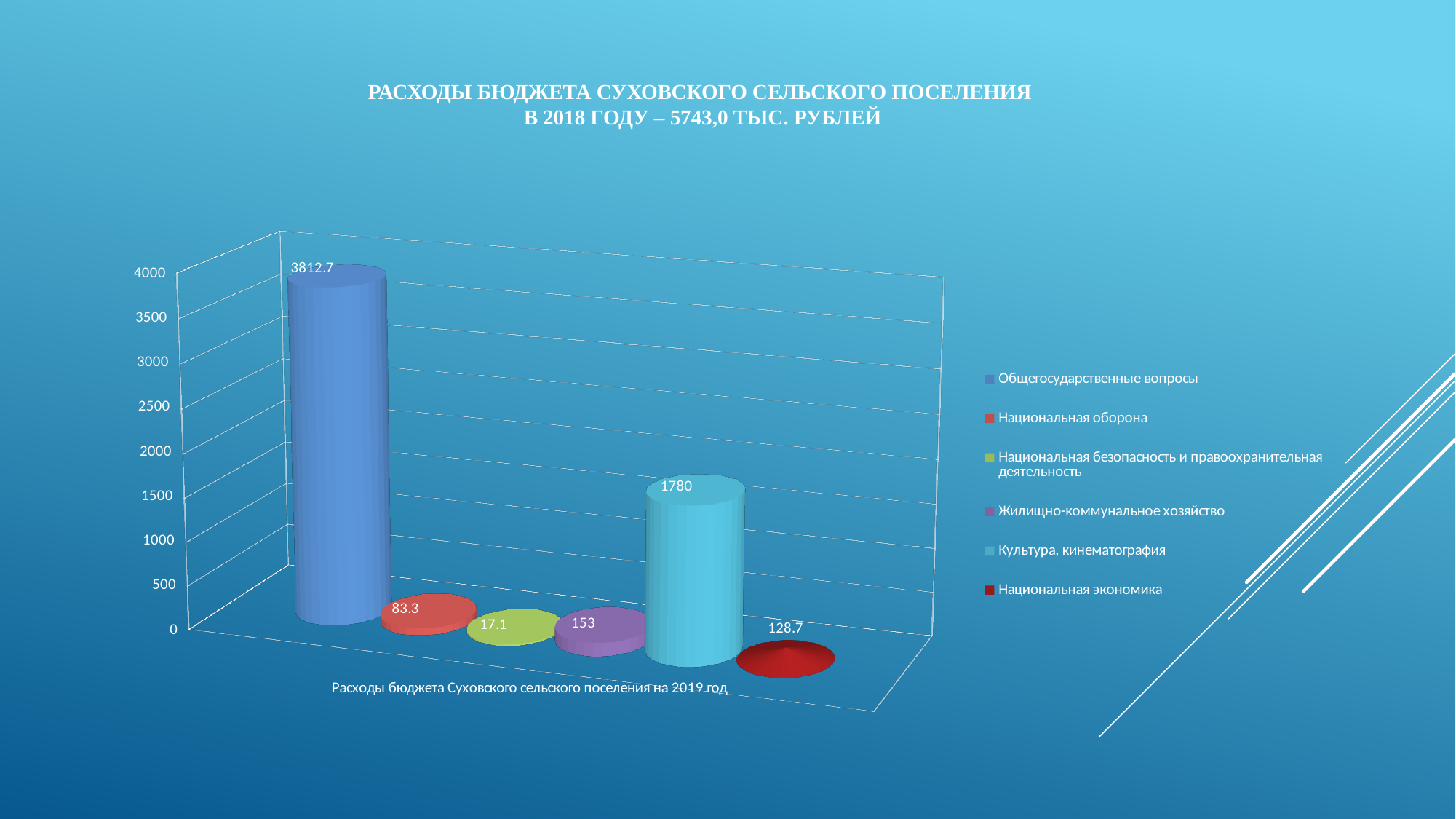
What is the value for Национальная оборона? 83.3 Which series has the lowest value? Национальная безопасность и правоохранительная деятельность How many series does the legend list? 6 What is the value for Общегосударственные вопросы? 3812.7 What is the difference between the values for Общегосударственные вопросы and Культура, кинематография? 2032.7 What is the value for Национальная экономика? 128.7 What is the value for Жилищно-коммунальное хозяйство? 153 What is the category label shown on the x axis of the chart? Расходы бюджета Суховского сельского поселения на 2019 год Which is larger, the value for Жилищно-коммунальное хозяйство or the value for Национальная экономика? Жилищно-коммунальное хозяйство What is the value for Культура, кинематография? 1780 Which series has the highest value? Общегосударственные вопросы What kind of chart is shown on the slide? Bar chart